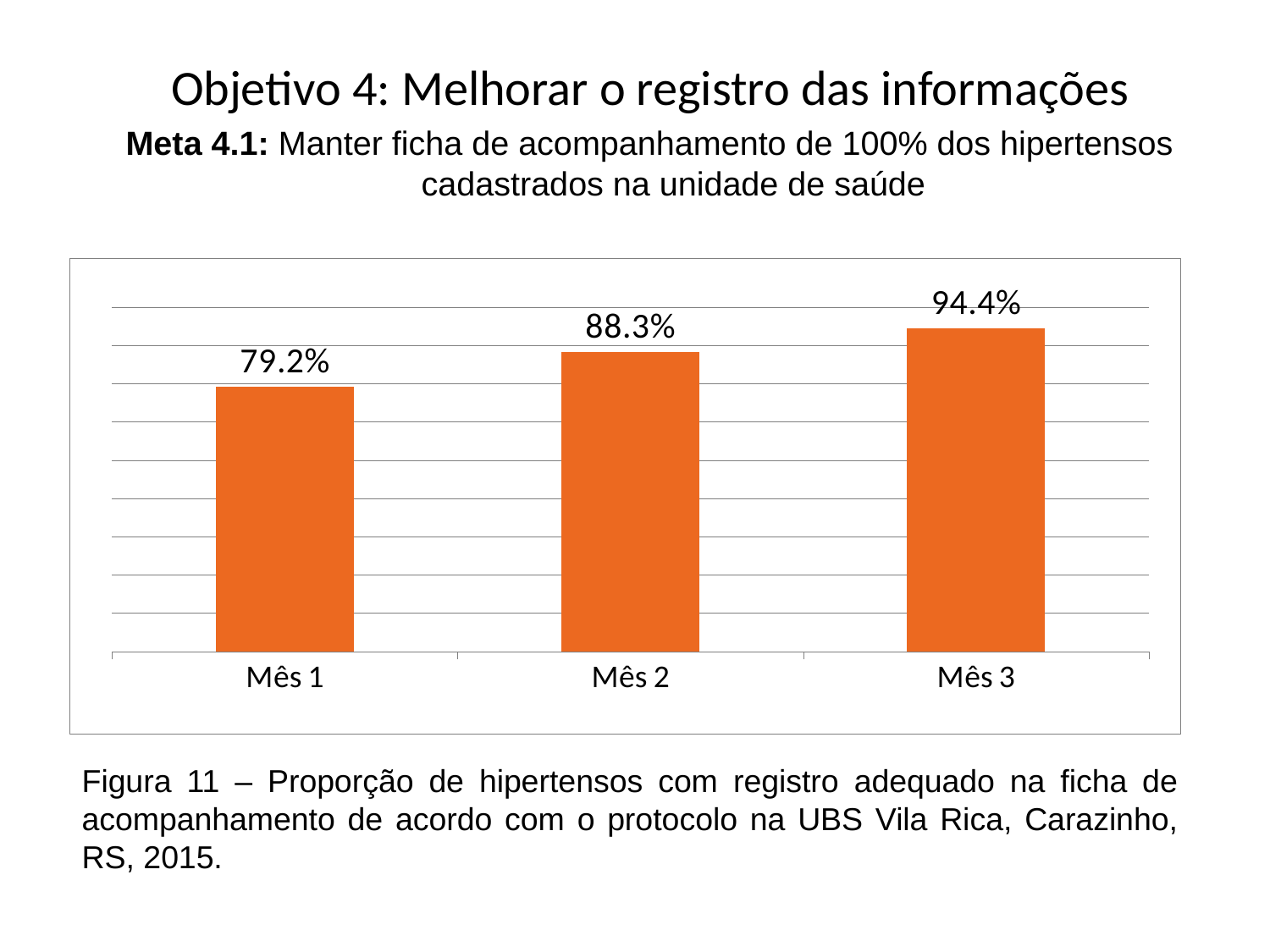
Which month has the lowest value? Mês 1 What kind of chart is shown on the slide? Bar chart How many categories are shown on the x axis? 3 What is the value for Mês 3? 94.4% What is the difference between the values for Mês 2 and Mês 1? 9.1% What is the difference between the values for Mês 3 and Mês 1? 15.2% Which month has the highest value? Mês 3 What is the value for Mês 2? 88.3% Which is larger, the value for Mês 2 or the value for Mês 3? Mês 3 Do the values rise or fall from Mês 1 to Mês 3? Rise What is the value for Mês 1? 79.2% What colour are the bars in the chart? Orange